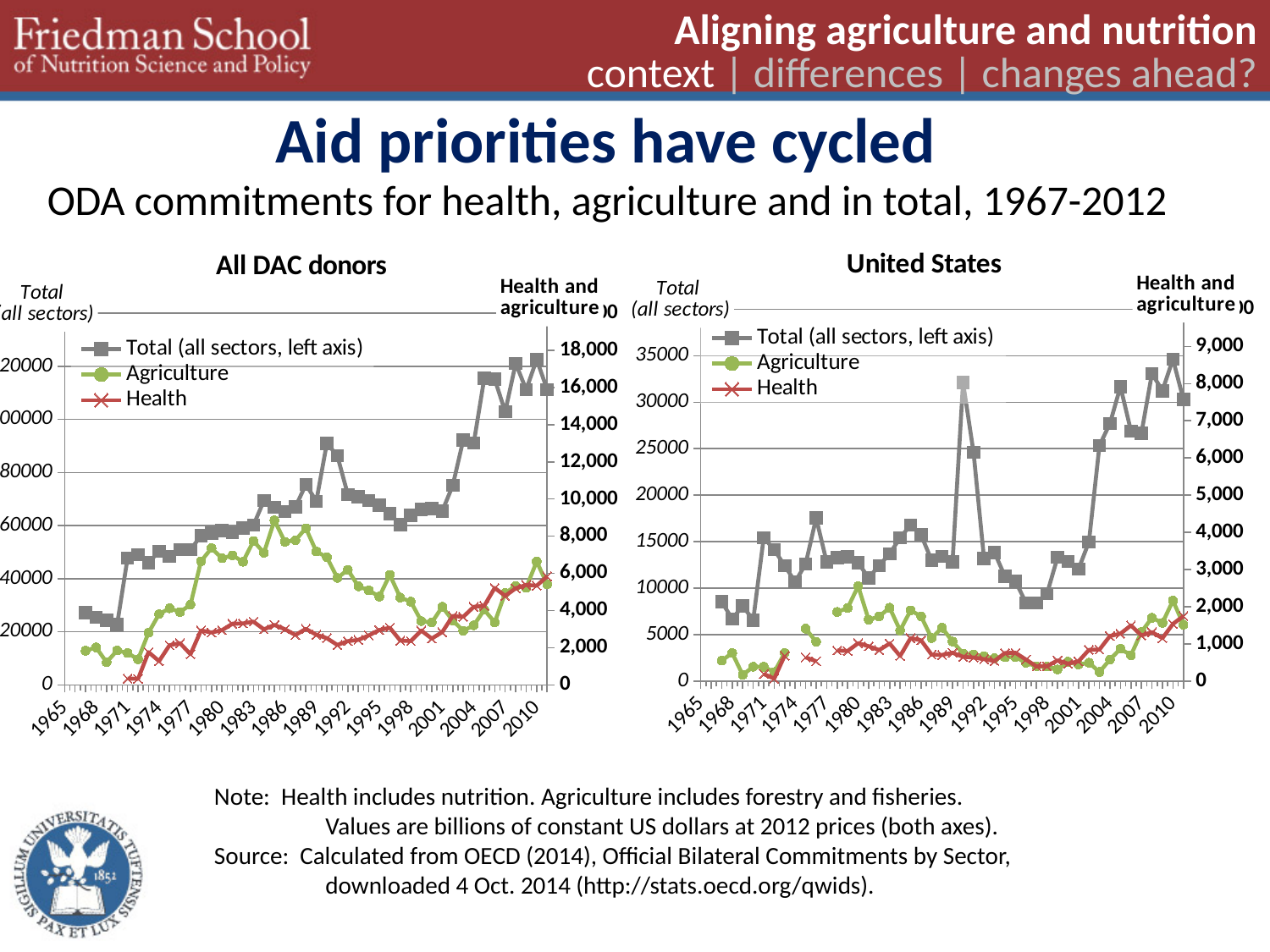
In the "United States" chart, is the Total (all sectors) value for 1991 greater or less than 30000? less What is the title of the chart on the right side of the slide? United States In the "All DAC donors" chart, is the Agriculture value for 1986 greater or less than 8,000? less In the "All DAC donors" chart, which is larger in 1986, Agriculture or Health? Agriculture In the "All DAC donors" chart, does the Total (all sectors) series generally rise or fall from 1967 to 2012? Rise How many series does the legend of the "United States" chart list? 3 In the "All DAC donors" chart, is the Total (all sectors) value for 2010 greater or less than 100000? greater What kind of chart is the "All DAC donors" chart? Line chart In the "All DAC donors" chart, which series is plotted on the left axis? Total (all sectors) In the "United States" chart, which is larger, the Total (all sectors) value for 1991 or for 1998? 1991